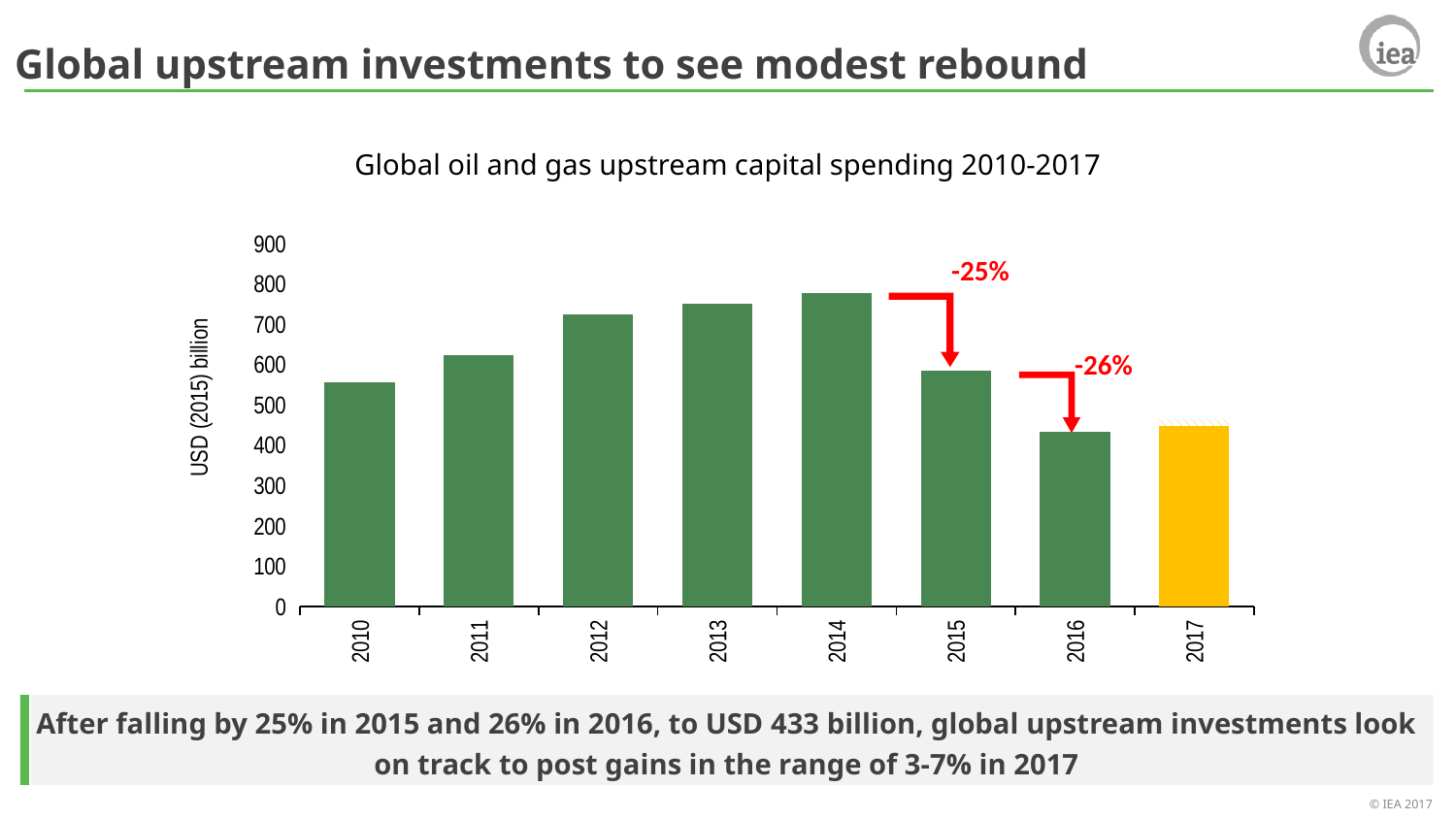
Which year has the lowest upstream capital spending in the chart? 2016 Is the value for 2016 greater or less than 500? less Which year has the highest upstream capital spending in the chart? 2014 Is the value for 2014 greater or less than 700? greater Which year has the larger value, 2010 or 2011? 2011 How many years are shown on the x axis of the chart? 8 Do the values rise or fall from 2010 to 2014? rise Which year has the larger value, 2012 or 2015? 2012 What type of chart is shown on the slide? bar chart Is the value for 2010 greater or less than 500? greater What percentage change is annotated on the chart between 2014 and 2015? -25% What percentage change is annotated on the chart between 2015 and 2016? -26%